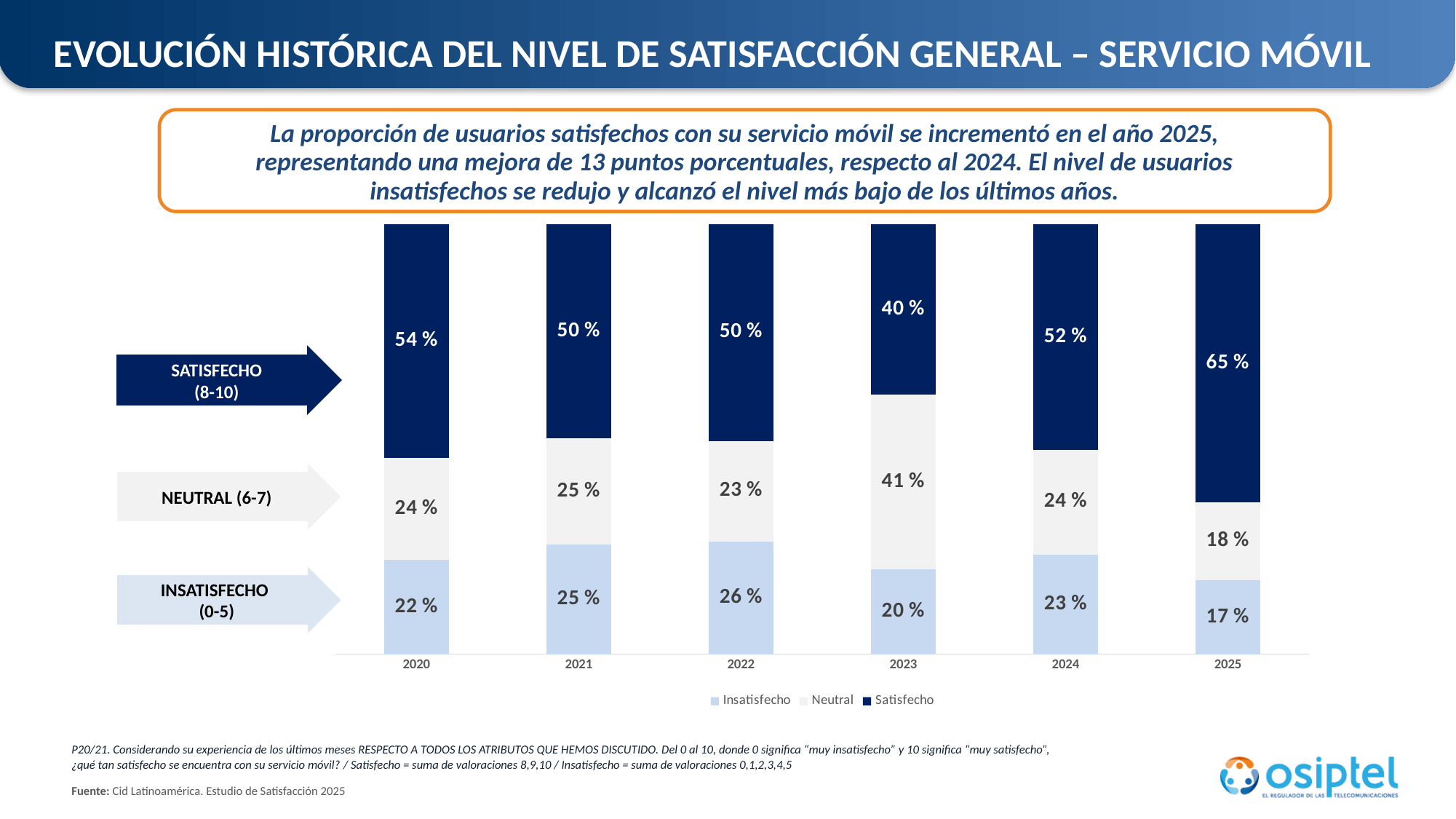
How many series does the legend list? 3 What is the difference between the Satisfecho values for 2025 and 2024? 13 percentage points What is the Satisfecho value for 2025? 65 % Which year has the lowest Satisfecho value? 2023 What is the Insatisfecho value for 2022? 26 % How many years are shown on the x axis? 6 What is the Neutral value for 2023? 41 % What kind of chart is shown on the slide? Stacked bar chart Which year has the highest Satisfecho value? 2025 Which is larger, the Neutral value for 2023 or the Neutral value for 2021? 2023 Which series is shown in dark blue in the legend? Satisfecho Which year has the lowest Insatisfecho value? 2025